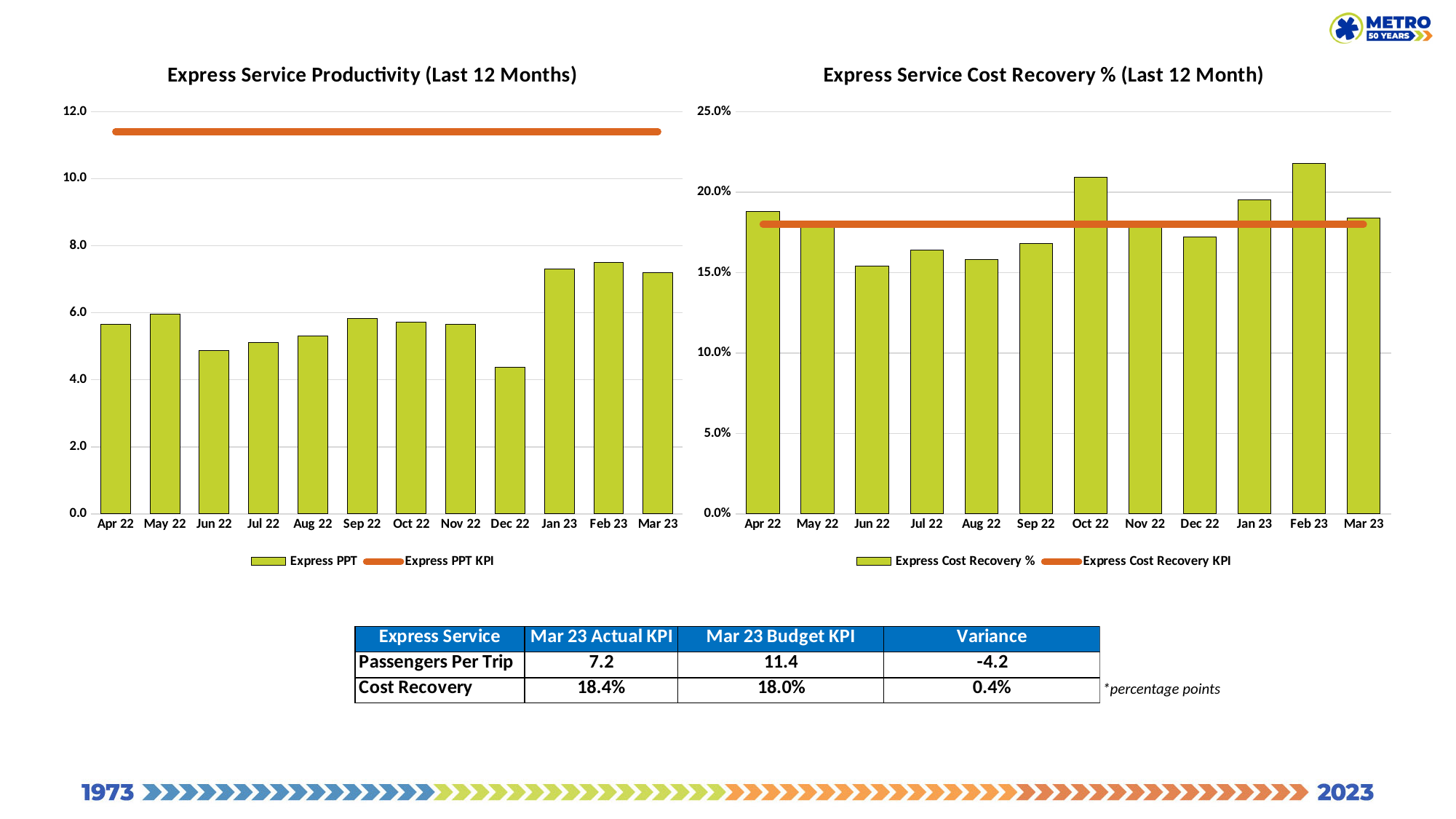
On the Express Service Cost Recovery % (Last 12 Month) chart, which month has the highest Express Cost Recovery % bar? Feb 23 What is the Mar 23 Actual KPI for Cost Recovery shown on the slide? 18.4% How many series does the legend of the Express Service Productivity (Last 12 Months) chart list? 2 How many months are plotted on the Express Service Cost Recovery % (Last 12 Month) chart? 12 On the Express Service Cost Recovery % (Last 12 Month) chart, which is larger, the bar for Sep 22 or for Oct 22? Oct 22 On the Express Service Productivity (Last 12 Months) chart, which month has the lowest Express PPT bar? Dec 22 What colour is the Express PPT KPI line on the Express Service Productivity (Last 12 Months) chart? orange On the Express Service Productivity (Last 12 Months) chart, which is larger, the Express PPT bar for Dec 22 or for Jan 23? Jan 23 On the Express Service Cost Recovery % (Last 12 Month) chart, is the value for Oct 22 greater or less than 20.0%? greater On the Express Service Productivity (Last 12 Months) chart, is the Express PPT value for Dec 22 greater or less than 6.0? less On the Express Service Productivity (Last 12 Months) chart, do the Express PPT values rise or fall from Dec 22 to Feb 23? rise What kind of chart is the Express Service Productivity (Last 12 Months) chart? bar chart